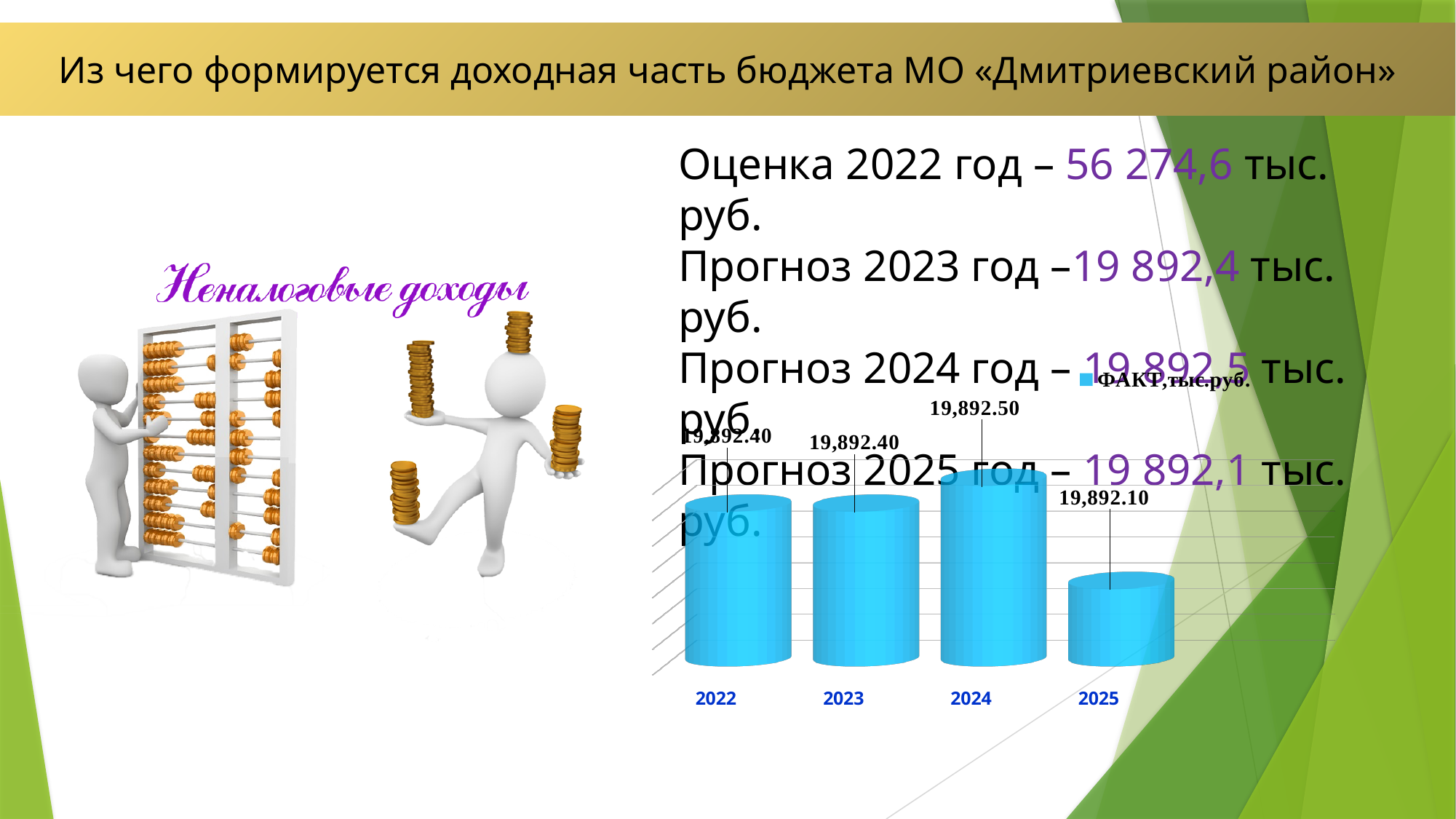
Which year has the lowest value in the chart? 2025 What kind of chart is shown on the slide? Bar chart What is the value shown for 2022 in the chart? 19,892.40 What is the value shown for 2025 in the chart? 19,892.10 What is the difference between the values for 2024 and 2025 in the chart? 0.40 What is the difference between the values for 2024 and 2023 in the chart? 0.10 How many years are shown on the x axis of the chart? 4 Which is larger in the chart, the value for 2024 or the value for 2025? 2024 How many series does the chart legend list? 1 What is the value shown for 2023 in the chart? 19,892.40 What is the value shown for 2024 in the chart? 19,892.50 Which year has the highest value in the chart? 2024